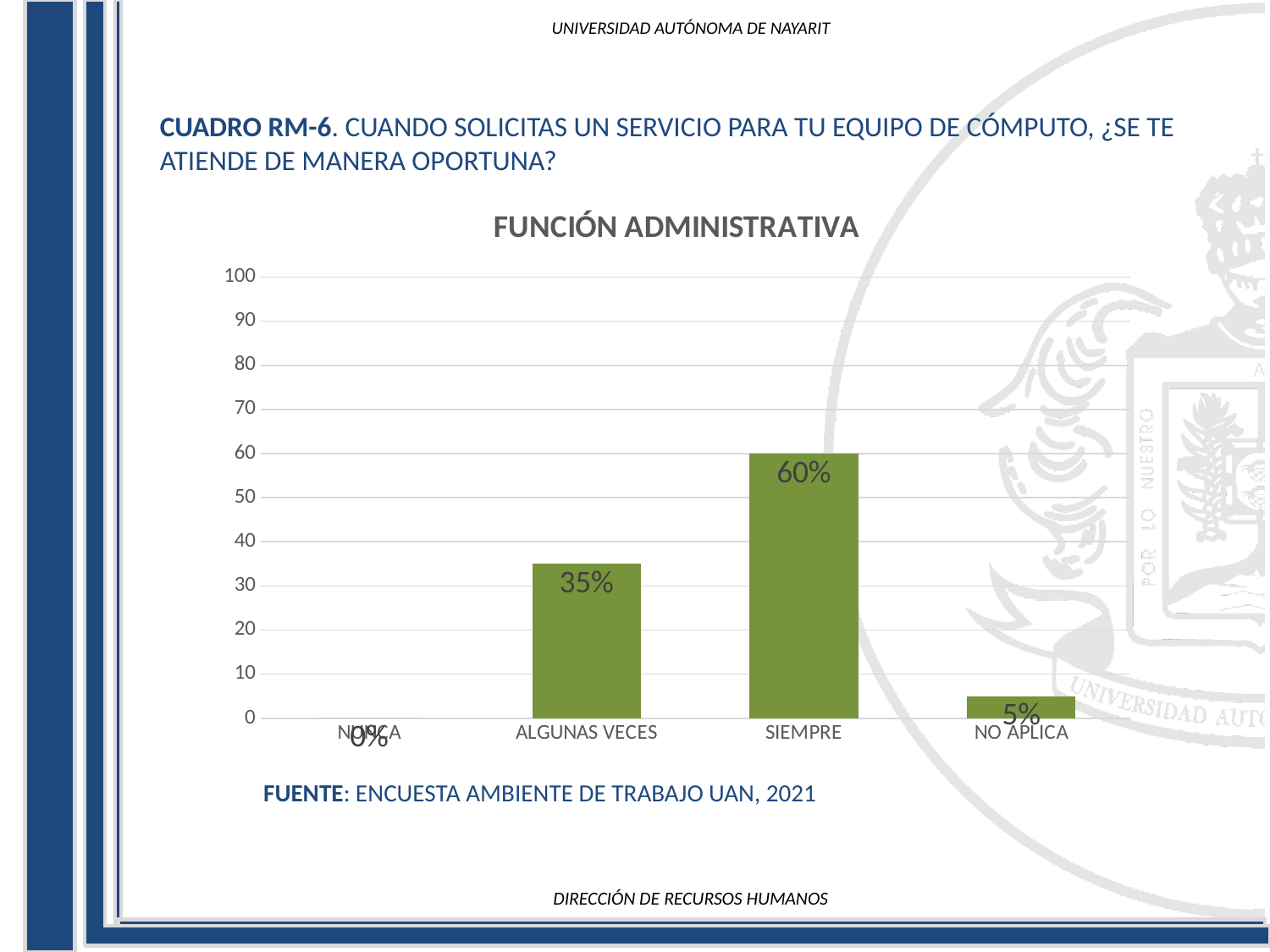
What kind of chart is shown? bar chart What is the value for NUNCA? 0% Which category has the highest value? SIEMPRE What is the title of the chart? FUNCIÓN ADMINISTRATIVA How many categories are shown on the x axis? 4 Is the value for SIEMPRE greater or less than 50? greater Which category has the lowest value? NUNCA Which is larger, the value for ALGUNAS VECES or the value for NO APLICA? ALGUNAS VECES What is the difference between the values for SIEMPRE and ALGUNAS VECES? 25% What is the value for ALGUNAS VECES? 35% What is the value for NO APLICA? 5% What is the value for SIEMPRE? 60%